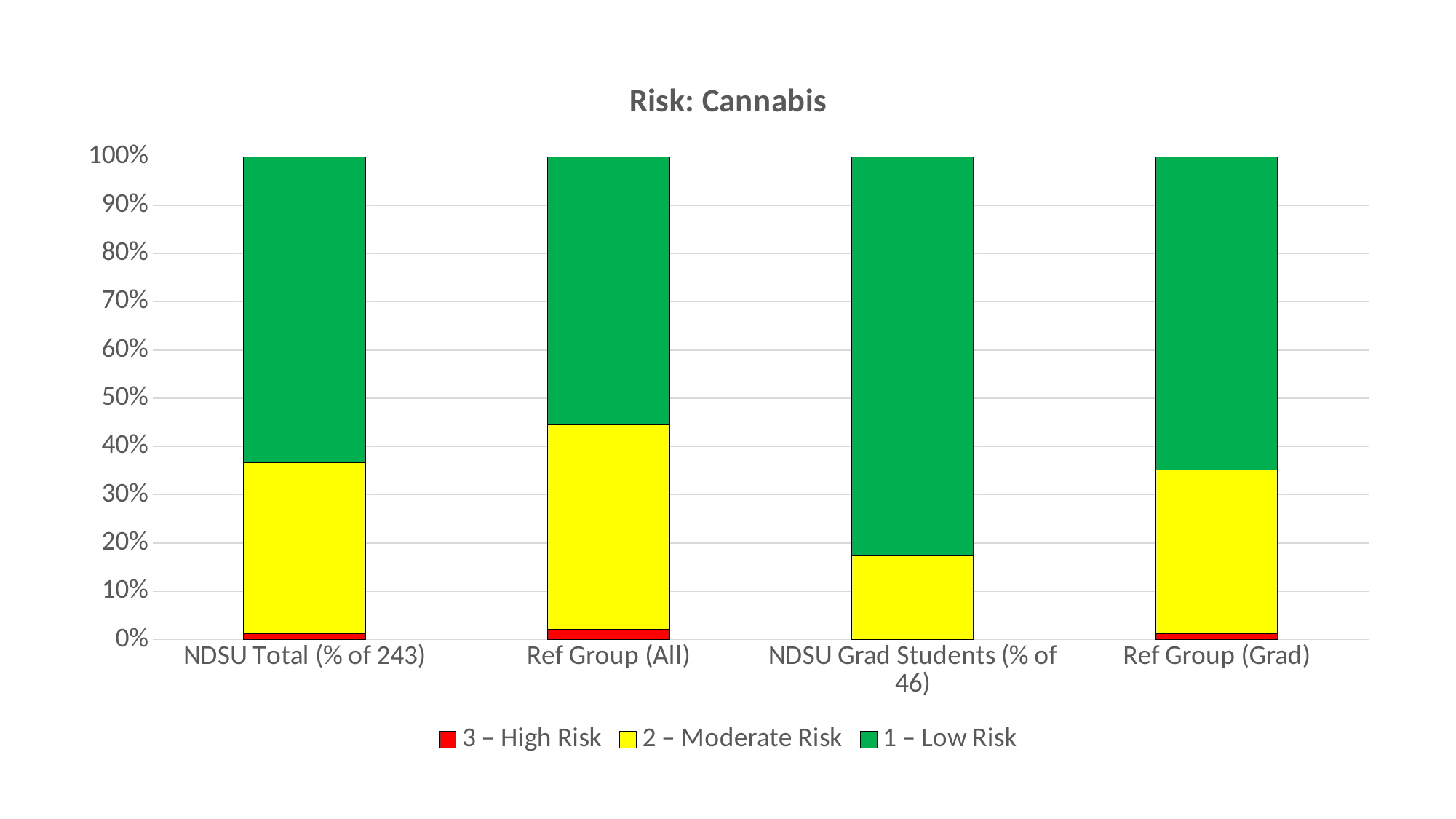
What is the total of the stacked bar for NDSU Total (% of 243)? 100% Which colour represents the 3 – High Risk series? Red Is the 2 – Moderate Risk value for Ref Group (All) greater or less than 40%? greater How many series does the legend list? 3 Which category has the smallest 2 – Moderate Risk share? NDSU Grad Students (% of 46) Is the 2 – Moderate Risk value for NDSU Grad Students (% of 46) greater or less than 20%? less Is the 2 – Moderate Risk share larger for Ref Group (All) or for NDSU Total (% of 243)? Ref Group (All) What kind of chart is shown on the slide? Stacked bar chart How many categories are shown along the x axis? 4 Which category has the largest 1 – Low Risk share? NDSU Grad Students (% of 46) What is the title of the chart? Risk: Cannabis Which category has the largest 2 – Moderate Risk share? Ref Group (All)